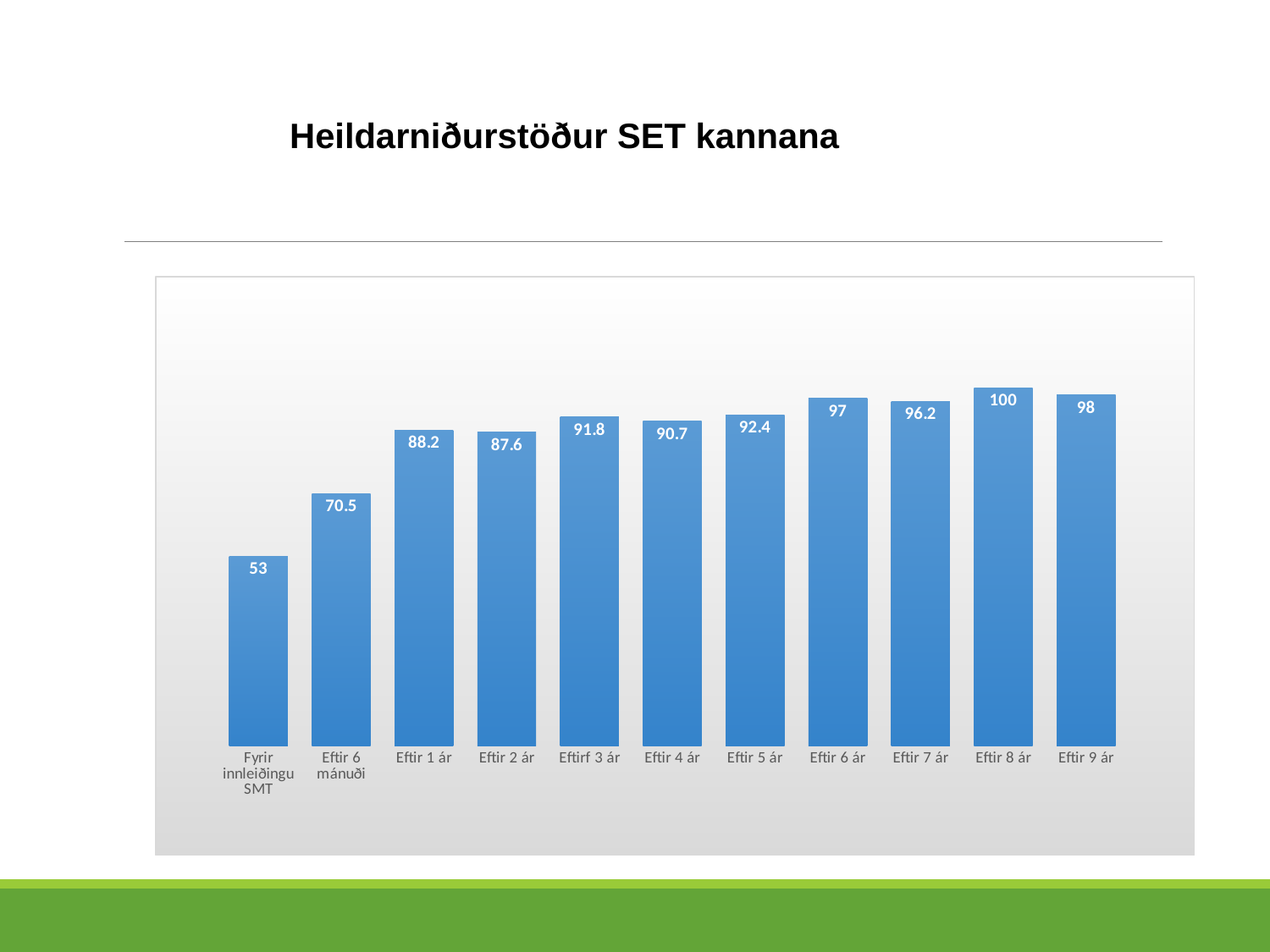
Do the values generally rise or fall from left to right along the x axis? Rise What is the difference between the values for Eftir 8 ár and Fyrir innleiðingu SMT? 47 What is the value for Eftir 6 mánuði? 70.5 What is the difference between the values for Eftir 1 ár and Eftir 6 mánuði? 17.7 How many categories are shown in the chart? 11 Which category has the lowest value? Fyrir innleiðingu SMT Which category has the highest value? Eftir 8 ár Which is larger, the value for Eftir 6 ár or the value for Eftir 7 ár? Eftir 6 ár Which is larger, the value for Eftir 1 ár or the value for Eftir 2 ár? Eftir 1 ár What kind of chart is shown on the slide? Bar chart What is the value for Fyrir innleiðingu SMT? 53 What is the value for Eftir 5 ár? 92.4